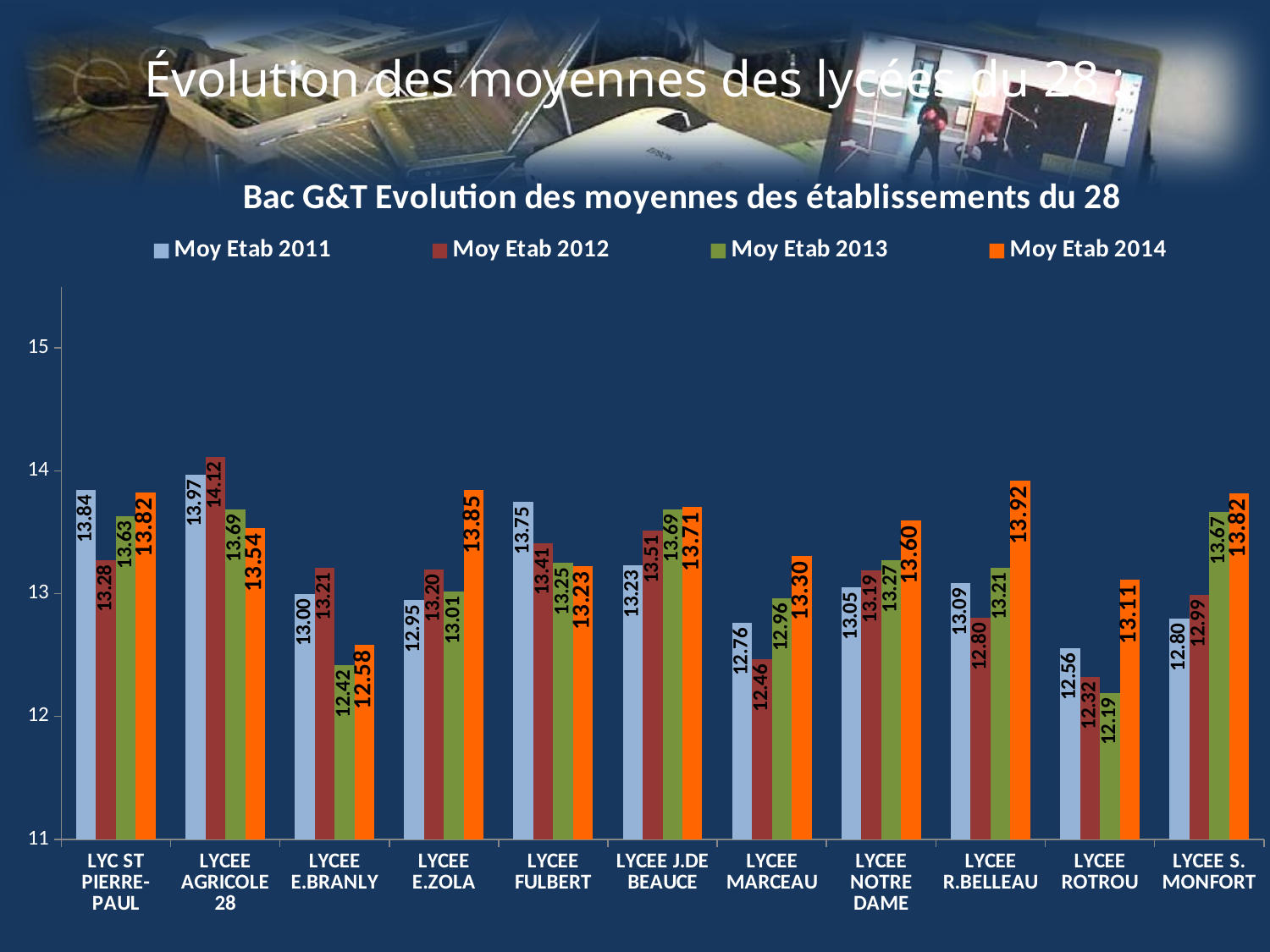
Which establishment has the highest Moy Etab 2012 value? LYCEE AGRICOLE 28 How many series does the legend list? 4 What is the difference between Moy Etab 2014 and Moy Etab 2011 for LYCEE E.ZOLA? 0.90 What is the value of Moy Etab 2011 for LYCEE FULBERT? 13.75 How many establishments are shown on the x axis? 11 What is the value of Moy Etab 2013 for LYCEE E.BRANLY? 12.42 What is the value of Moy Etab 2014 for LYCEE R.BELLEAU? 13.92 Which is larger for LYCEE MARCEAU: Moy Etab 2011 or Moy Etab 2014? Moy Etab 2014 For LYCEE J.DE BEAUCE, do the values rise or fall from Moy Etab 2011 to Moy Etab 2014? Rise What kind of chart is shown on the slide? Bar chart Which establishment has the lowest Moy Etab 2013 value? LYCEE ROTROU Which establishment has the lowest Moy Etab 2014 value? LYCEE E.BRANLY